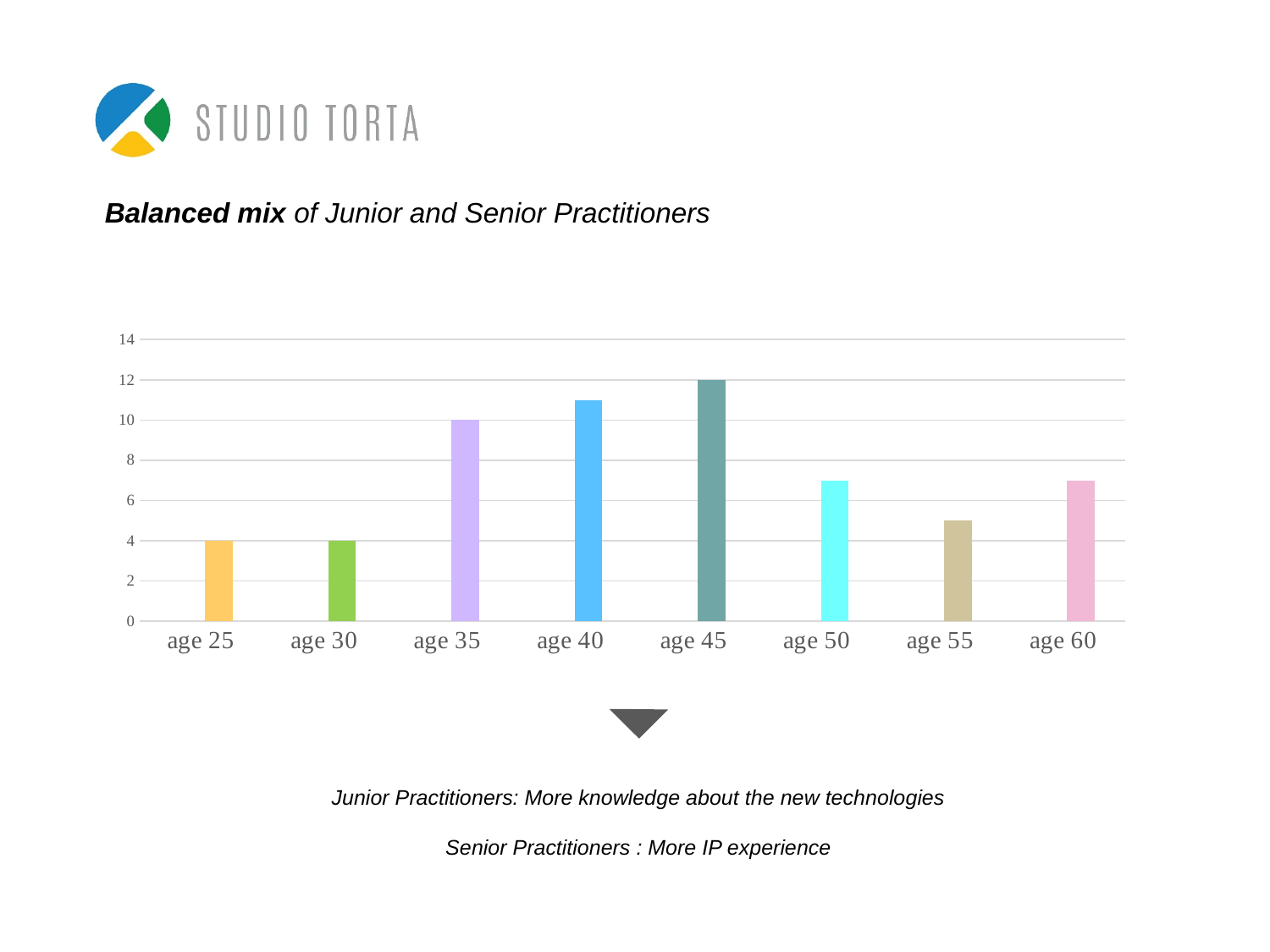
What kind of chart is shown on the slide? bar chart How many age categories are shown on the x axis? 8 What is the difference between the values for age 45 and age 35? 2 What is the value for age 25? 4 What is the value for age 30? 4 Is the value for age 40 greater or less than 10? greater Which is larger, the value for age 40 or the value for age 50? age 40 What is the value for age 45? 12 Which age category has the highest value? age 45 What is the value for age 35? 10 Is the value for age 55 greater or less than 4? greater Is the value for age 60 greater or less than 8? less